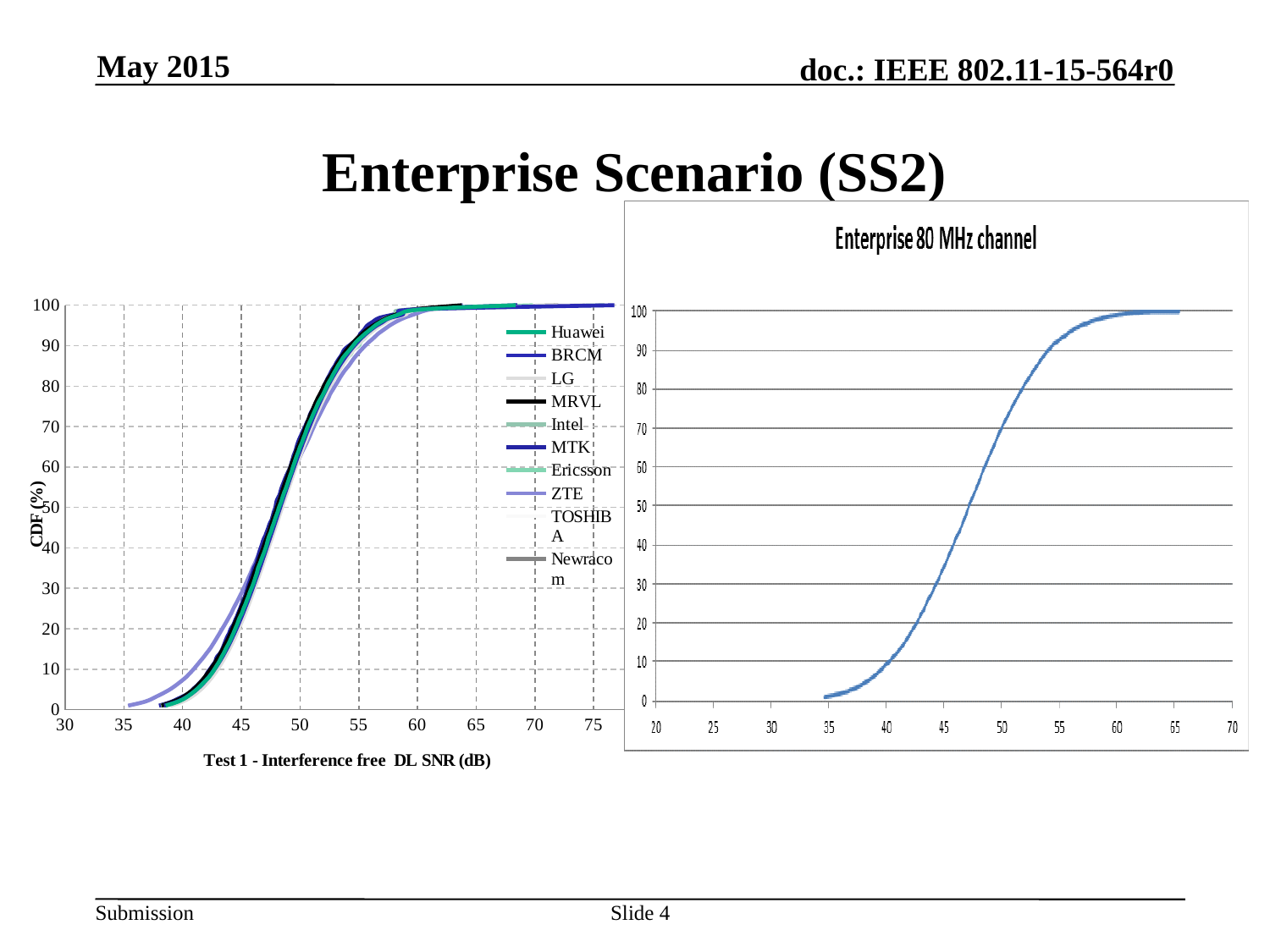
In the right chart, does the curve rise or fall as the x-axis value increases? rise In the right chart, is the CDF value at 40 greater or less than 20? less In the right chart, is the CDF value at 50 greater or less than 60? greater In the left chart, is the ZTE CDF value at 40 dB greater or less than 20? less How many series does the legend of the left chart list? 10 In the left chart, do the CDF curves rise or fall as SNR increases along the x axis? rise What kind of chart is the left chart on the slide? line chart What is the title of the right chart? Enterprise 80 MHz channel What is the x-axis label of the left chart? Test 1 - Interference free DL SNR (dB) In the left chart, which curve reaches 10% CDF at a lower SNR, ZTE or Huawei? ZTE